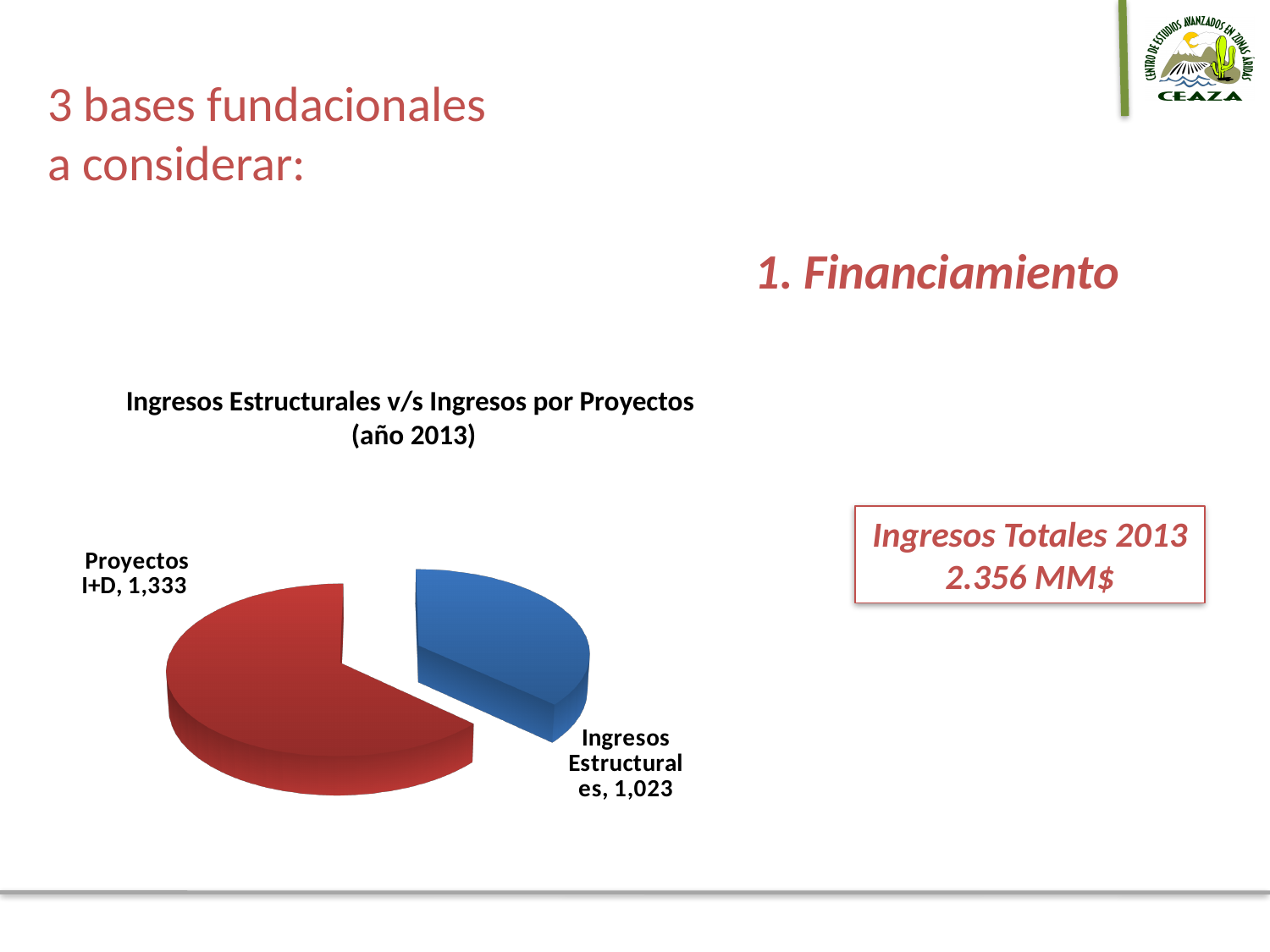
Which slice of the pie chart is the largest? Proyectos I+D What is the title of the pie chart? Ingresos Estructurales v/s Ingresos por Proyectos (año 2013) Which slice of the pie chart is the smallest? Ingresos Estructurales What is the total of the two slices in the pie chart? 2,356 What is the difference between the Proyectos I+D value and the Ingresos Estructurales value? 310 What is the value for Proyectos I+D in the pie chart? 1,333 What is the value for Ingresos Estructurales in the pie chart? 1,023 What type of chart is shown on the slide? Pie chart How many slices does the pie chart have? 2 What colour is the Proyectos I+D slice in the pie chart? Red Which is larger, Proyectos I+D or Ingresos Estructurales? Proyectos I+D